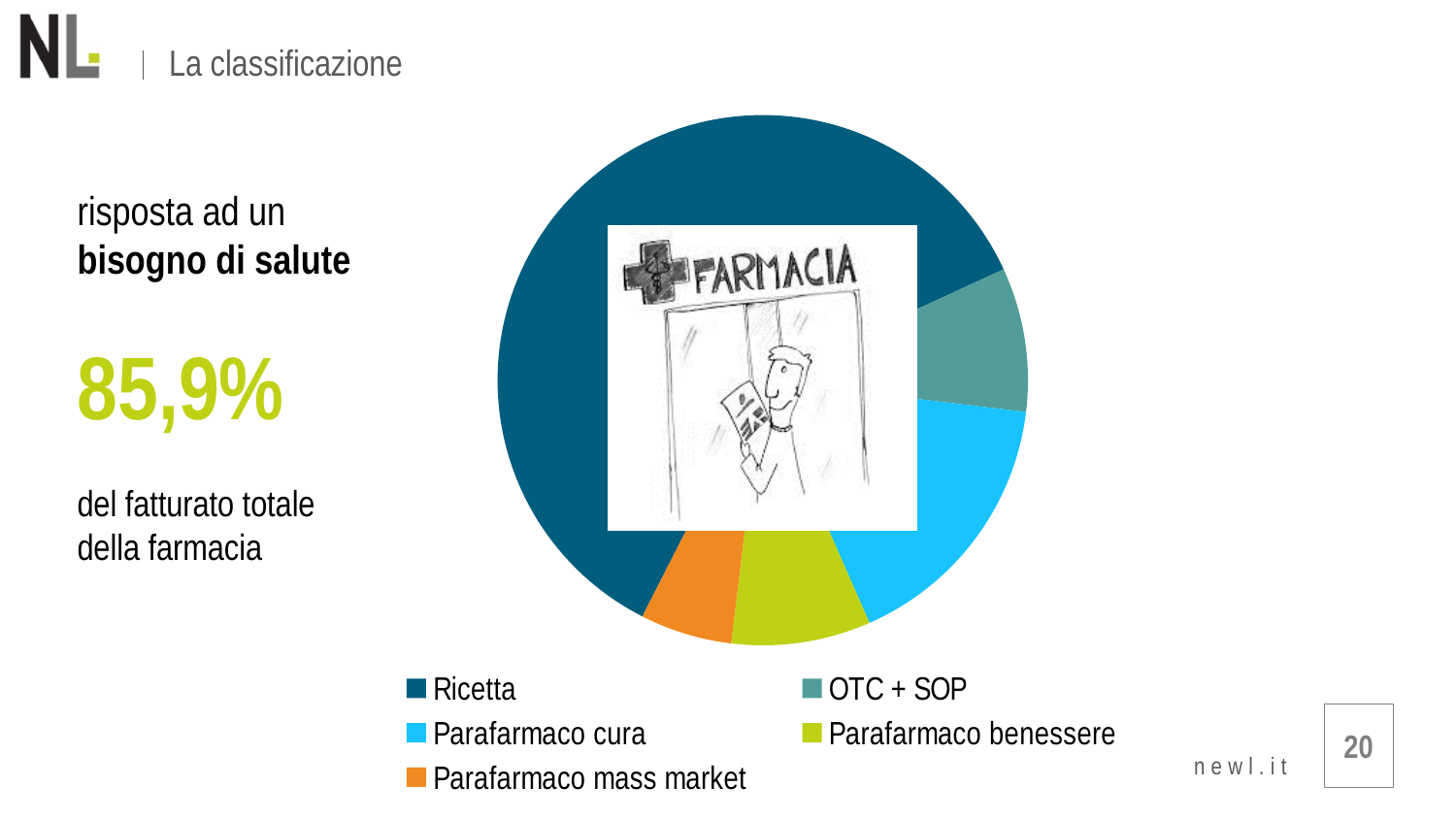
Does the Ricetta slice take up more or less than half of the pie? more How many slices does the pie chart have? 5 Which slice is larger, Ricetta or Parafarmaco cura? Ricetta Which slice is larger, Parafarmaco cura or Parafarmaco mass market? Parafarmaco cura Which category has the largest slice in the pie chart? Ricetta Which slice is larger, Ricetta or OTC + SOP? Ricetta Which legend entry is shown in light blue? Parafarmaco cura What kind of chart is shown on the slide? pie chart What colour is the Parafarmaco mass market slice in the pie chart? orange How many entries does the legend of the pie chart list? 5